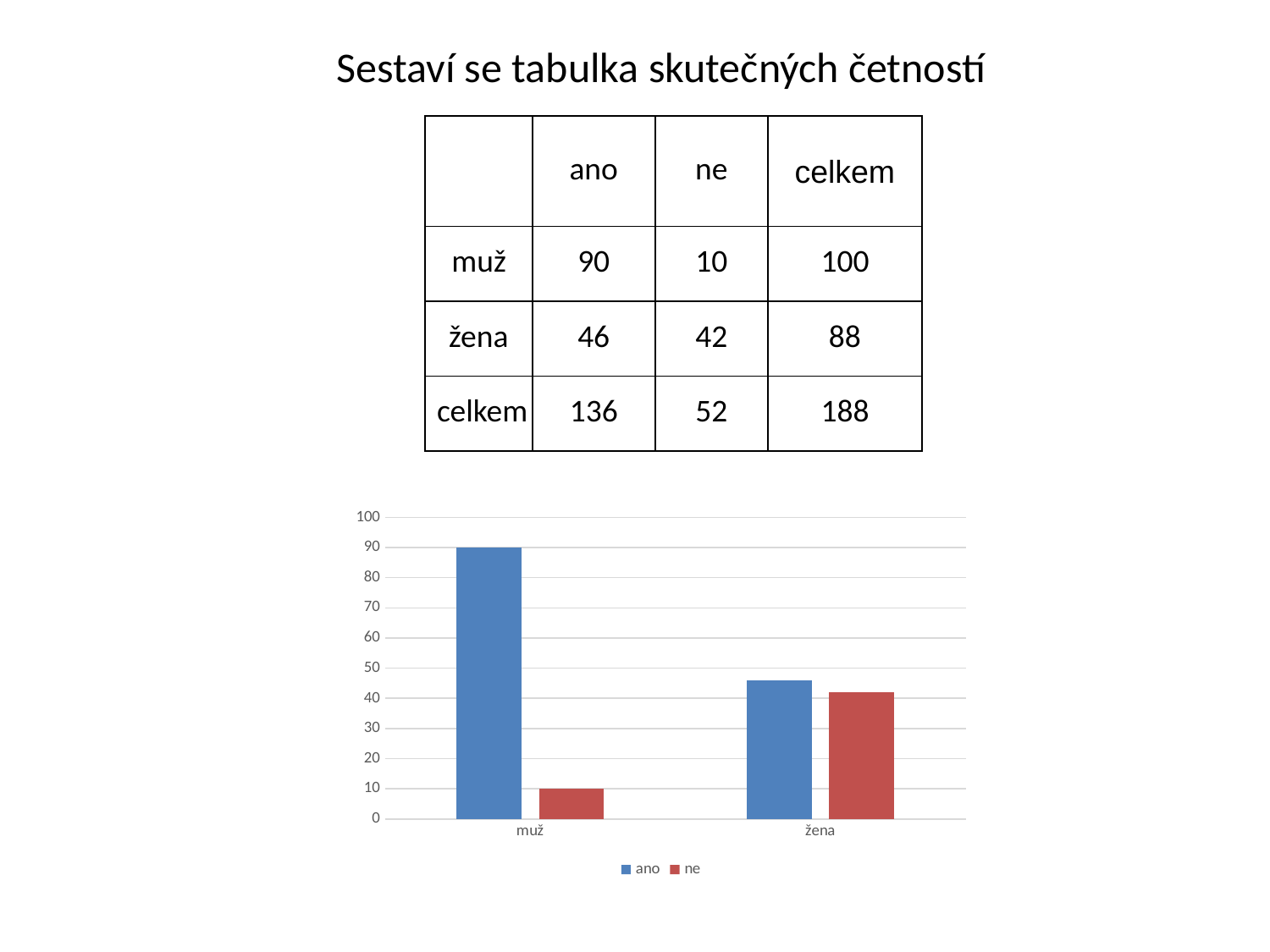
What is the difference between the 'ano' and 'ne' values for muž? 80 How many series does the chart legend list? 2 What is the value of the 'ano' bar for muž? 90 What is the value of the 'ne' bar for muž? 10 Is the 'ano' value for žena greater or less than 40? greater What kind of chart is shown on the slide? bar chart What is the value of the 'ne' bar for žena? 42 What are the series names in the chart legend? ano, ne What is the value of the 'ano' bar for žena? 46 Which bar is the tallest in the chart? ano for muž Is the 'ne' value for žena greater or less than 50? less How many categories are shown on the x axis of the chart? 2